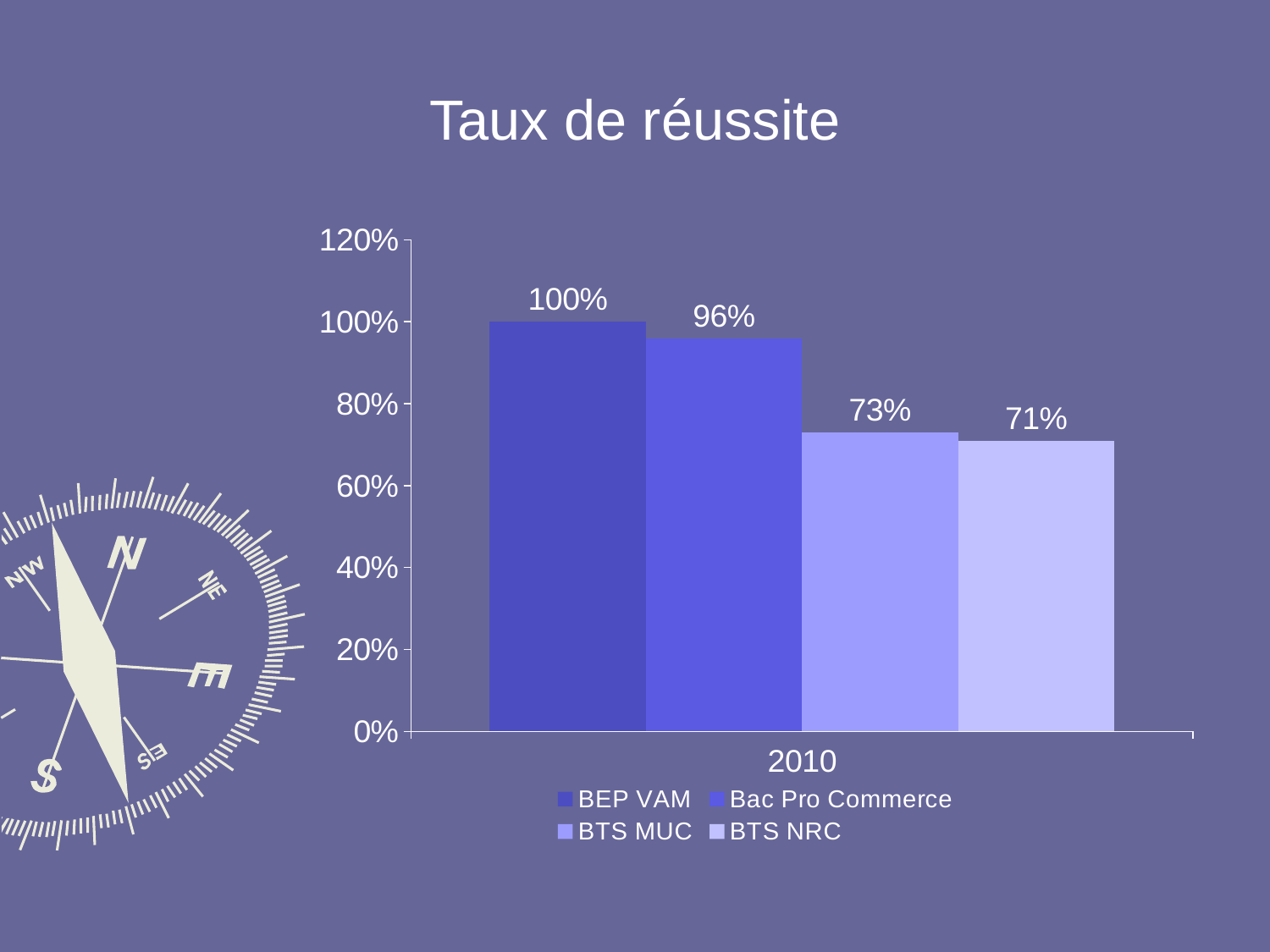
What is the success rate for BTS NRC in 2010? 71% How many series does the legend list? 4 Which series has the lowest success rate? BTS NRC What is the difference between the success rates of Bac Pro Commerce and BTS MUC? 23% What is the success rate for BEP VAM in 2010? 100% Which series has the highest success rate? BEP VAM Which has a higher success rate, Bac Pro Commerce or BTS MUC? Bac Pro Commerce What kind of chart is shown on the slide? Bar chart What is the success rate for Bac Pro Commerce in 2010? 96% What is the title of the chart? Taux de réussite What is the difference between the success rates of BEP VAM and BTS NRC? 29% What is the success rate for BTS MUC in 2010? 73%